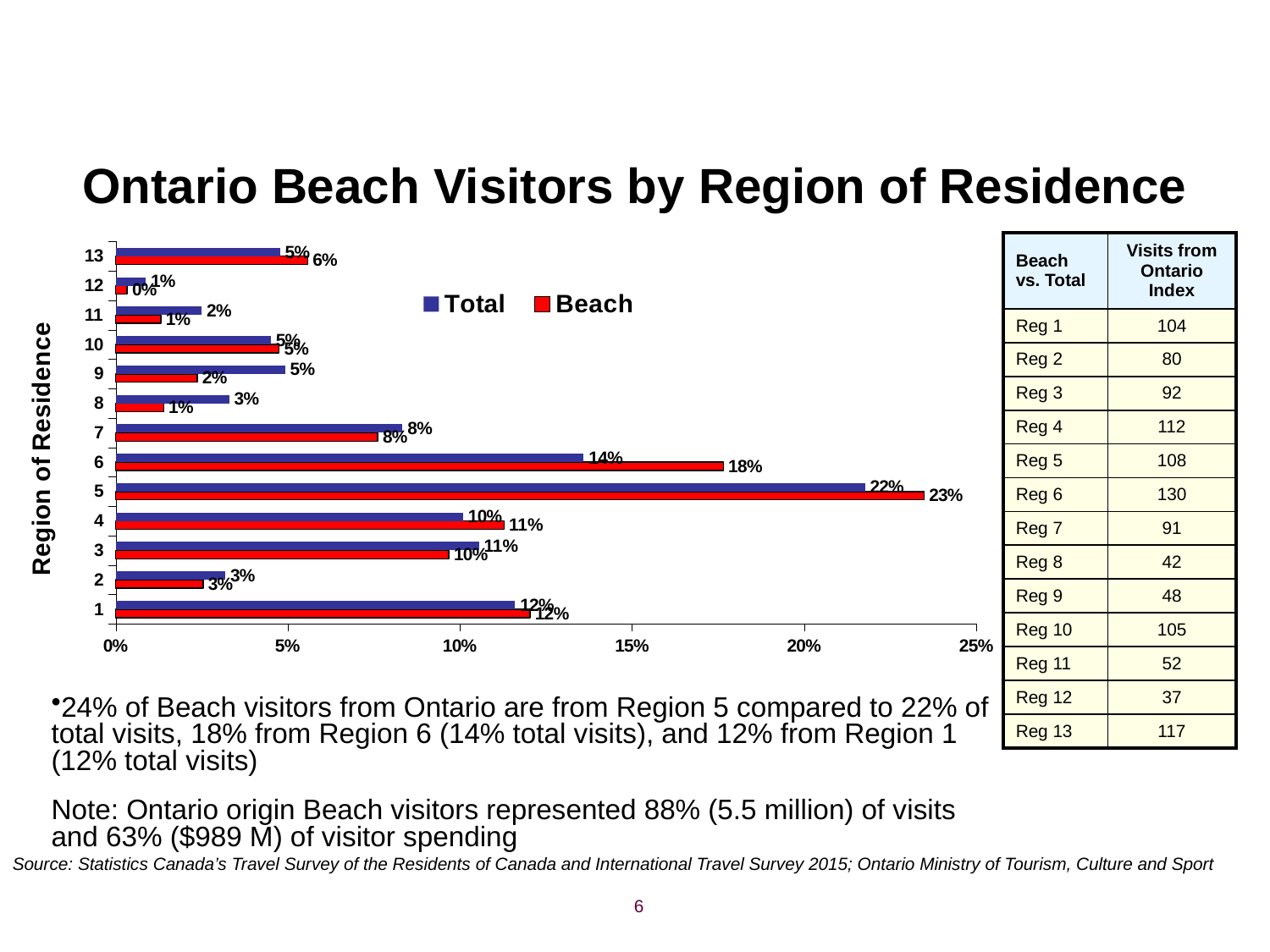
What is the difference between the Beach and Total values for Region 6? 4% What kind of chart is shown on the slide? bar chart How many regions are shown on the chart? 13 What is the Total value for Region 5? 22% Which is larger for Region 9, the Total value or the Beach value? Total How many series does the legend list? 2 What is the Beach value for Region 9? 2% What is the Beach value for Region 6? 18% What colour are the Beach bars? red Which region has the highest Beach value? 5 Is the Beach value for Region 5 greater or less than 20%? greater Which region has the lowest Beach value? 12